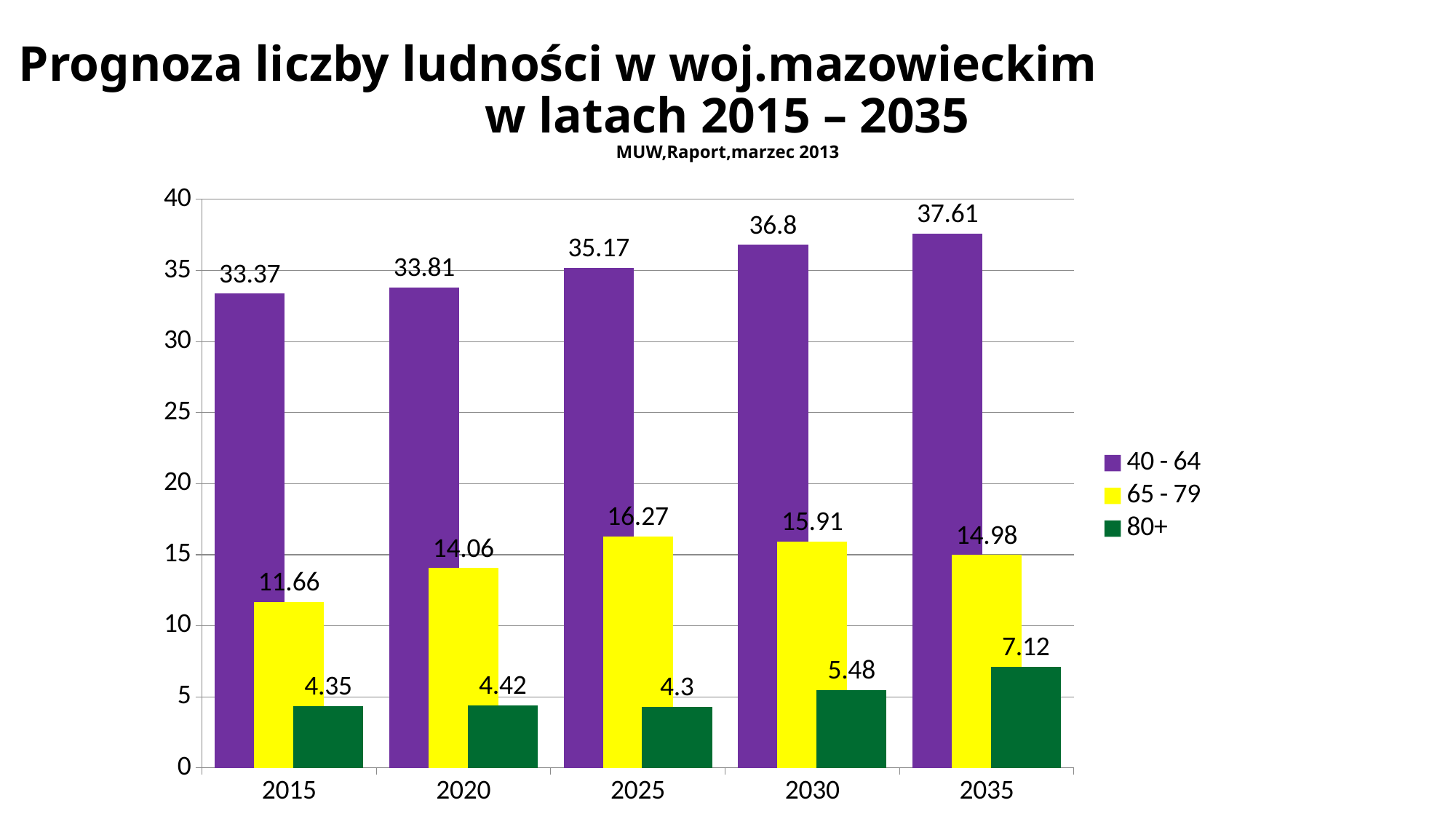
In which year is the 65 - 79 series highest? 2025 What is the value for the 40 - 64 series in 2035? 37.61 Does the 40 - 64 series rise or fall from 2015 to 2035? rise What colour are the bars for the 80+ series? green In which year is the 80+ series lowest? 2025 Which is larger: the 65 - 79 value in 2020 or in 2035? 2035 What is the value for the 80+ series in 2030? 5.48 How many years are shown on the x axis? 5 What is the difference between the 40 - 64 values in 2035 and 2015? 4.24 What kind of chart is shown on the slide? bar chart What is the value for the 65 - 79 series in 2015? 11.66 How many series does the legend list? 3